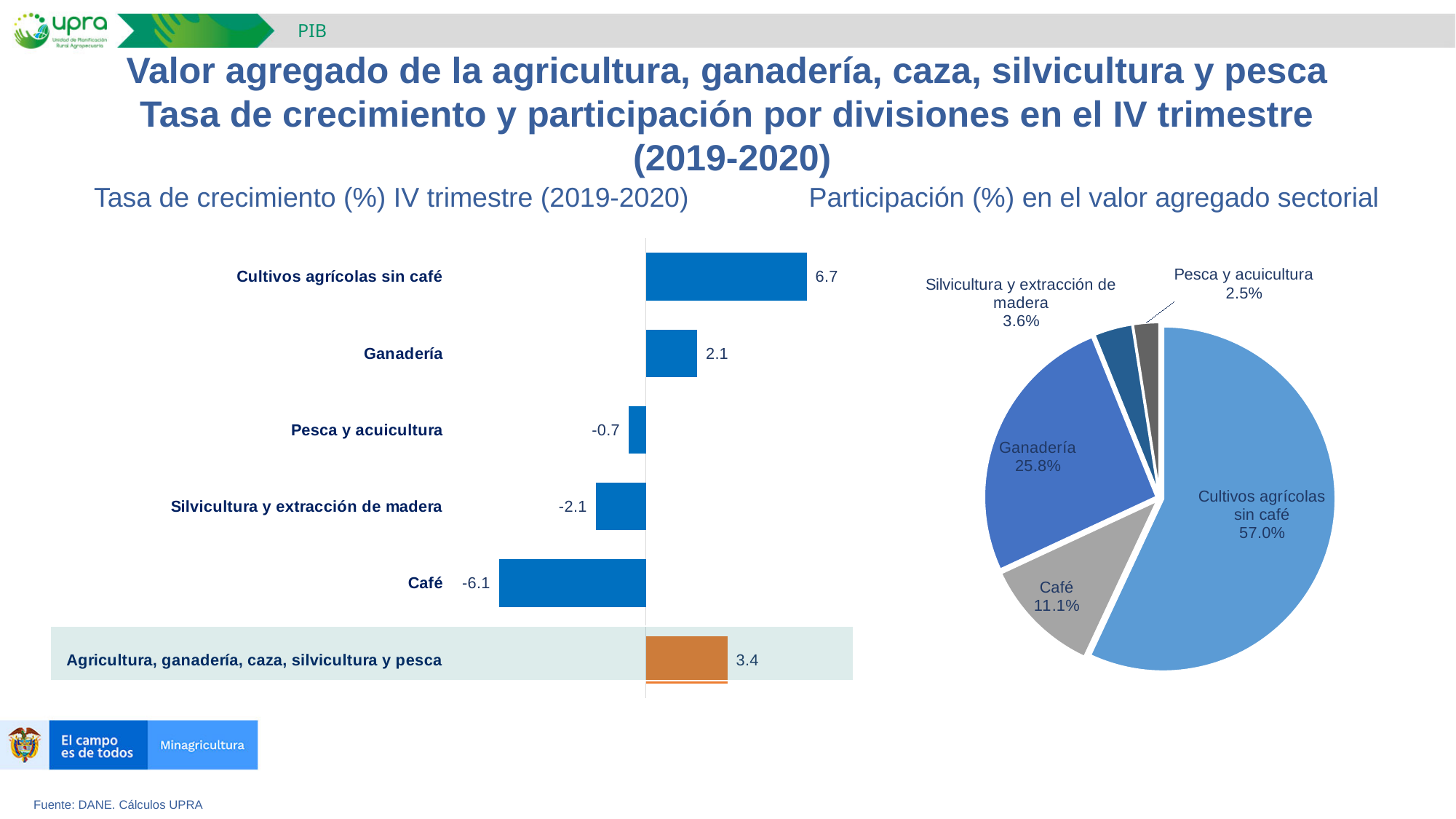
In the 'Tasa de crecimiento (%) IV trimestre (2019-2020)' chart, what is the value for Cultivos agrícolas sin café? 6.7 In the 'Tasa de crecimiento (%) IV trimestre (2019-2020)' chart, which category has the lowest value? Café In the 'Participación (%) en el valor agregado sectorial' pie chart, which slice is the smallest? Pesca y acuicultura In the 'Tasa de crecimiento (%) IV trimestre (2019-2020)' chart, which category has the highest value? Cultivos agrícolas sin café In the 'Tasa de crecimiento (%) IV trimestre (2019-2020)' chart, what is the value for Agricultura, ganadería, caza, silvicultura y pesca? 3.4 What kind of chart is the 'Tasa de crecimiento (%) IV trimestre (2019-2020)' chart? Bar chart In the 'Tasa de crecimiento (%) IV trimestre (2019-2020)' chart, what is the value for Café? -6.1 In the 'Tasa de crecimiento (%) IV trimestre (2019-2020)' chart, which is larger, the value for Pesca y acuicultura or the value for Silvicultura y extracción de madera? Pesca y acuicultura In the 'Participación (%) en el valor agregado sectorial' pie chart, what share does Ganadería have? 25.8% How many categories are shown in the 'Tasa de crecimiento (%) IV trimestre (2019-2020)' chart? 6 In the 'Tasa de crecimiento (%) IV trimestre (2019-2020)' chart, what is the difference between the values for Ganadería and Pesca y acuicultura? 2.8 What kind of chart is the 'Participación (%) en el valor agregado sectorial' chart? Pie chart